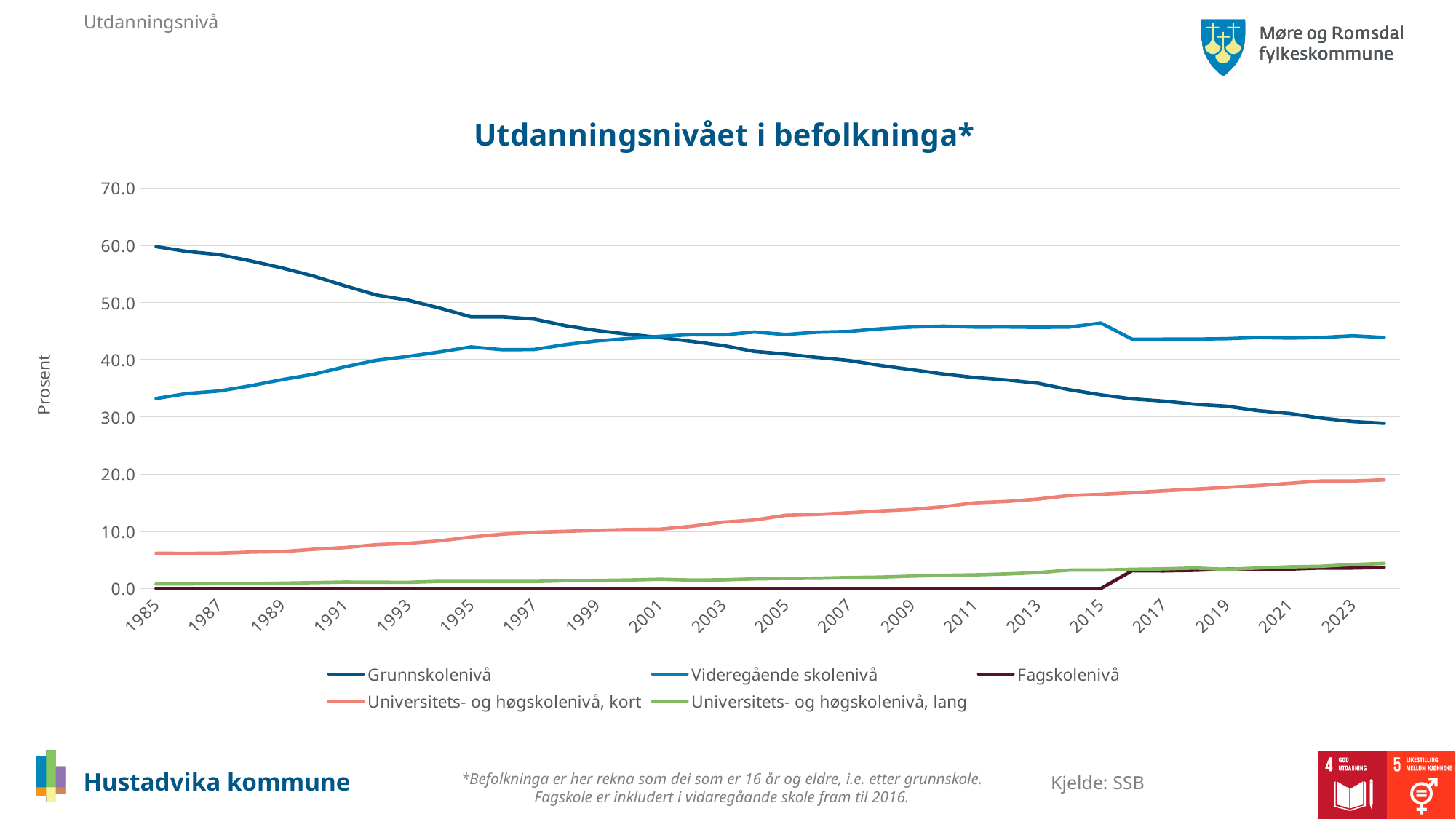
What is the title of the chart? Utdanningsnivået i befolkninga* Does the Grunnskolenivå line rise or fall from 1985 to 2023? fall What is the label on the y axis? Prosent Is the value for Videregående skolenivå in 1985 greater or less than 40? less Is the value for Universitets- og høgskolenivå, kort in 2023 greater or less than 20? less What kind of chart is shown on the slide? line chart Does the Universitets- og høgskolenivå, kort line rise or fall from 1985 to 2023? rise In 1985, which is larger: Grunnskolenivå or Videregående skolenivå? Grunnskolenivå Is the value for Grunnskolenivå in 1985 greater or less than 50? greater How many series does the legend list? 5 Which series has the highest value in 2023? Videregående skolenivå